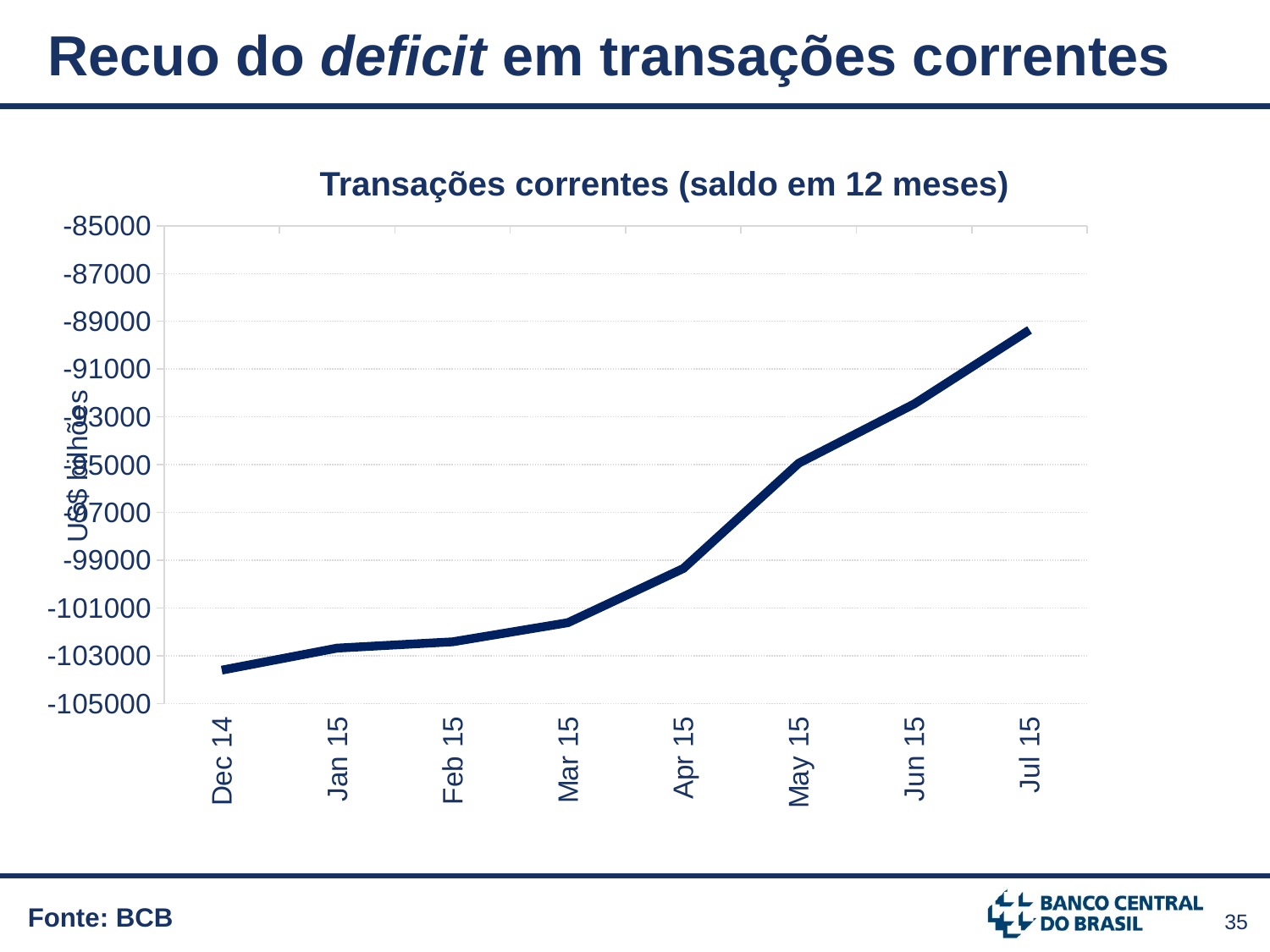
What is the title of the chart? Transações correntes (saldo em 12 meses) What kind of chart is shown on the slide? line chart Is the value for Jul 15 greater or less than -91000? greater Which month has the highest (least negative) value on the chart? Jul 15 Is the value for Jun 15 greater or less than -93000? greater Which month has the lowest (most negative) value on the chart? Dec 14 How many months are plotted on the x axis of the chart? 8 Is the value for Mar 15 greater or less than -101000? less Do the values rise or fall from Dec 14 to Jul 15? rise Which is larger, the value for Jul 15 or the value for Dec 14? Jul 15 Which is larger, the value for May 15 or the value for Mar 15? May 15